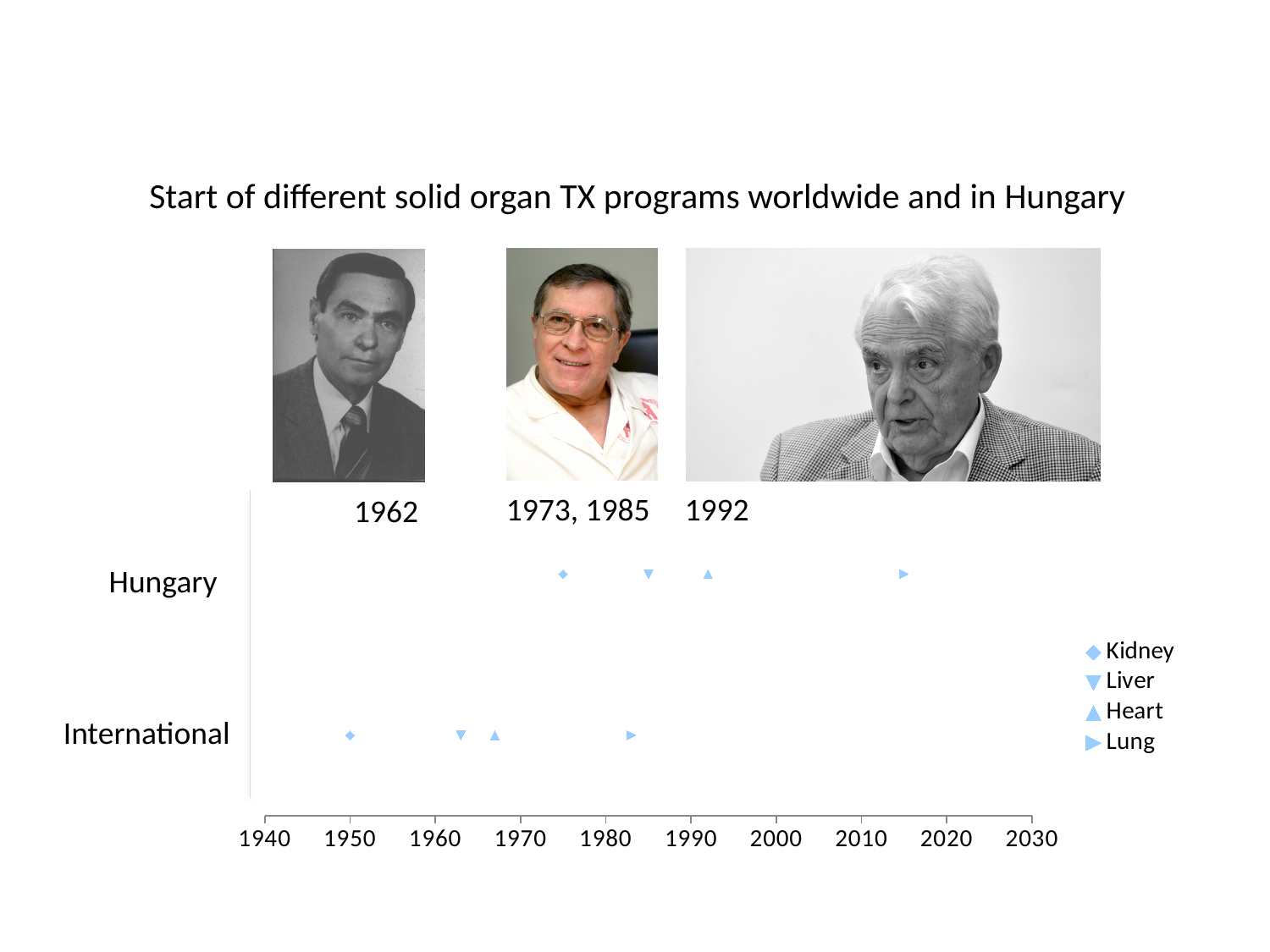
Is the start year of the International Liver program greater or less than 1970? less Which started later, the Kidney program in Hungary or the International Kidney program? Hungary What kind of chart is shown on the slide? scatter chart What is the title of the chart? Start of different solid organ TX programs worldwide and in Hungary Is the start year of the International Kidney program greater or less than 1960? less How many series does the legend list? 4 Is the start year of the Hungary Heart program greater or less than 1980? greater Which organ program started earliest in the International row? Kidney How many categories are shown on the vertical axis of the chart? 2 Which organ programs are listed in the chart legend? Kidney, Liver, Heart, Lung